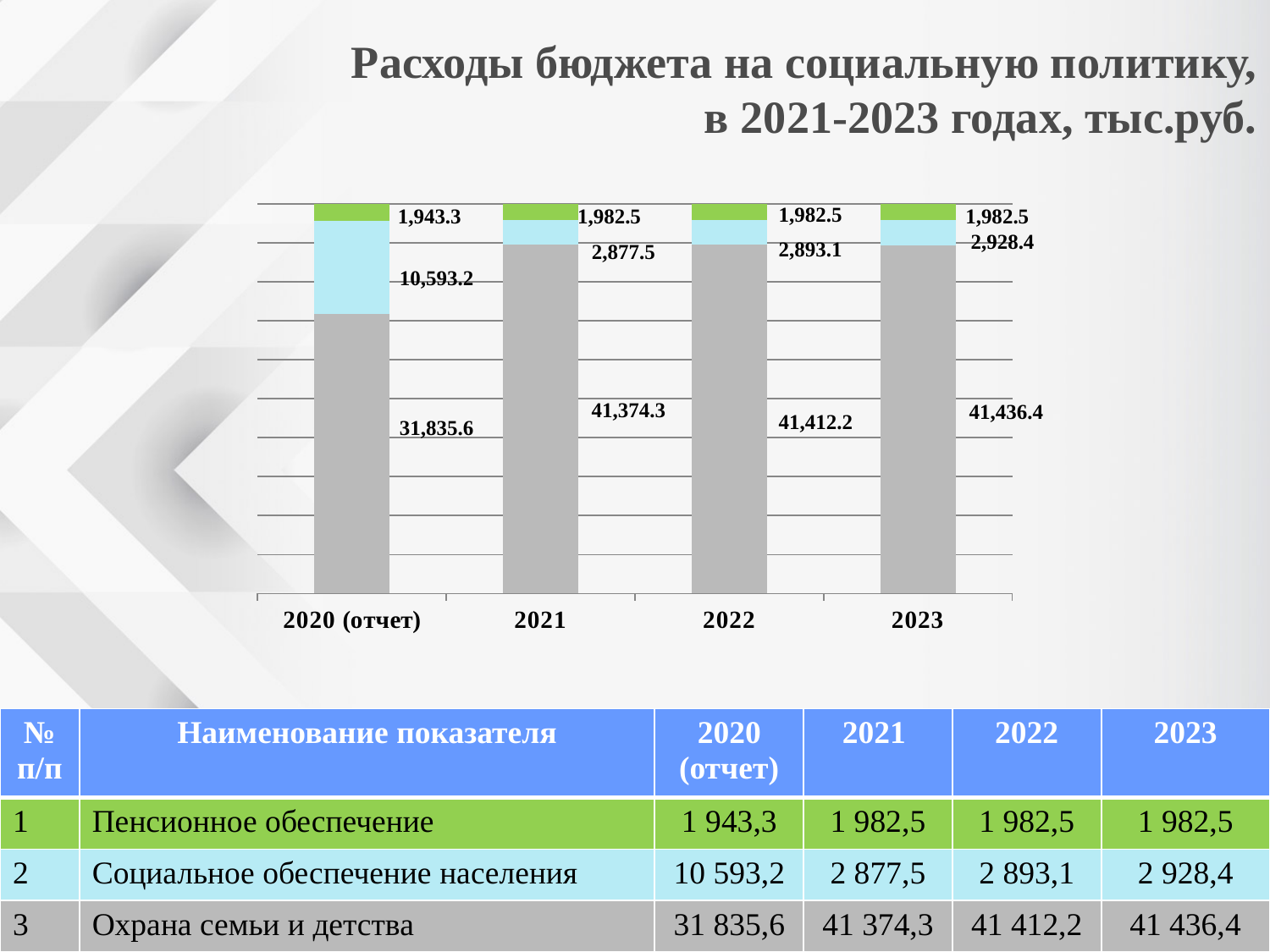
What is the value of the light blue segment (Социальное обеспечение населения) for 2021? 2,877.5 Does the gray segment (Охрана семьи и детства) rise or fall from 2021 to 2023? Rise In which year is the gray segment (Охрана семьи и детства) the lowest? 2020 (отчет) What kind of chart is shown on the slide? Stacked bar chart What is the value of the light blue segment (Социальное обеспечение населения) for 2022? 2,893.1 What is the total of the stacked bar for 2023? 46,347.3 What is the value of the green segment (Пенсионное обеспечение) for 2023? 1,982.5 By how much does the gray segment (Охрана семьи и детства) in 2021 exceed that in 2020 (отчет)? 9,538.7 How many years (categories) are shown on the x axis of the chart? 4 What is the value of the gray segment (Охрана семьи и детства) for 2020 (отчет)? 31,835.6 Which is larger: the light blue segment for 2020 (отчет) or for 2023? 2020 (отчет) In which year is the light blue segment (Социальное обеспечение населения) the highest? 2020 (отчет)